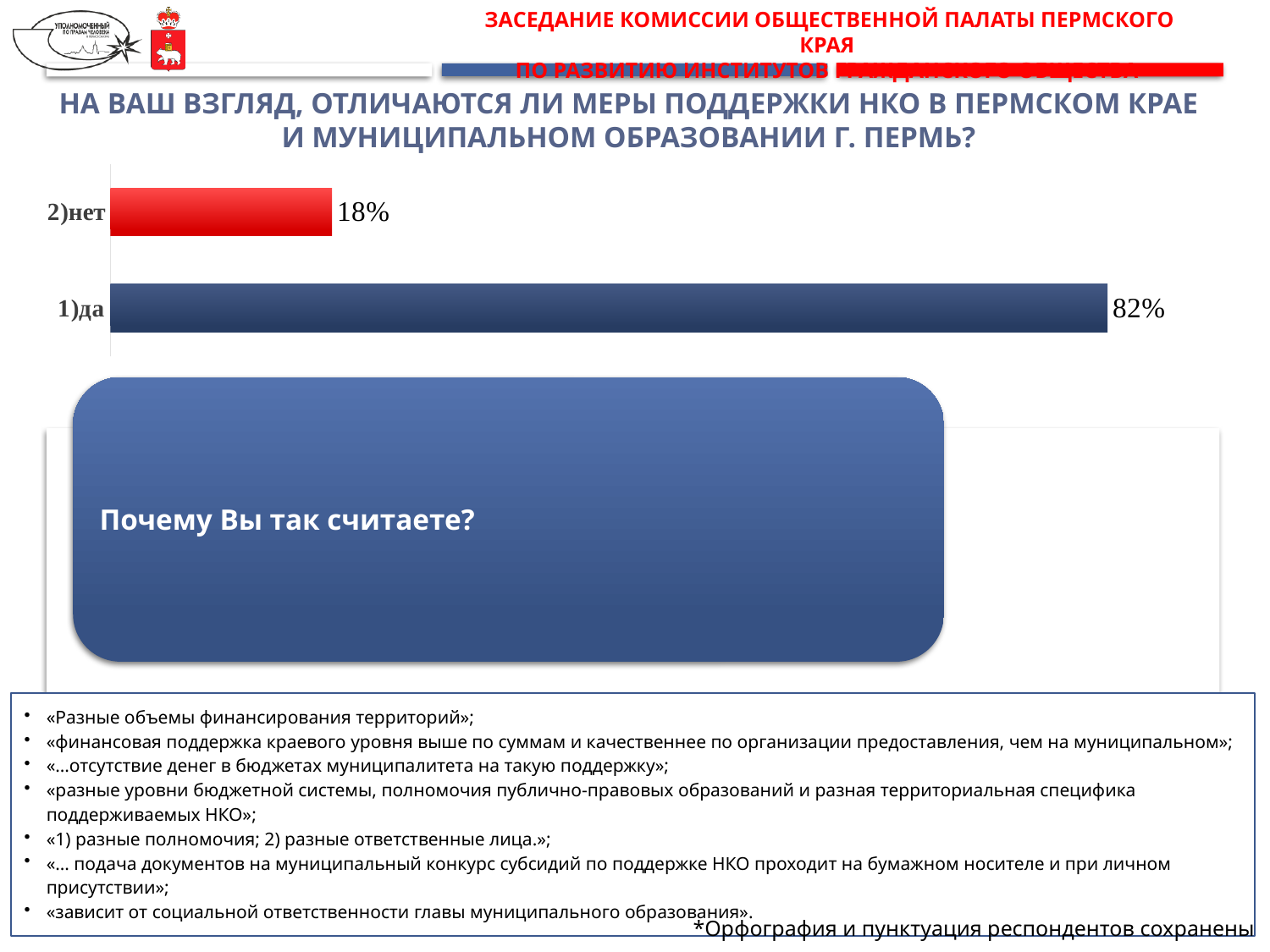
What is the difference between the values for "1)да" and "2)нет"? 64% Which category has the highest value? 1)да How many categories are shown in the chart? 2 What colour is the bar for "2)нет"? red Which is larger, the value for "1)да" or the value for "2)нет"? 1)да What colour is the bar for "1)да"? dark blue What is the total of the two values shown in the chart? 100% Which category has the lowest value? 2)нет What is the value for the category "1)да"? 82% What is the value for the category "2)нет"? 18% What kind of chart is shown on the slide? bar chart